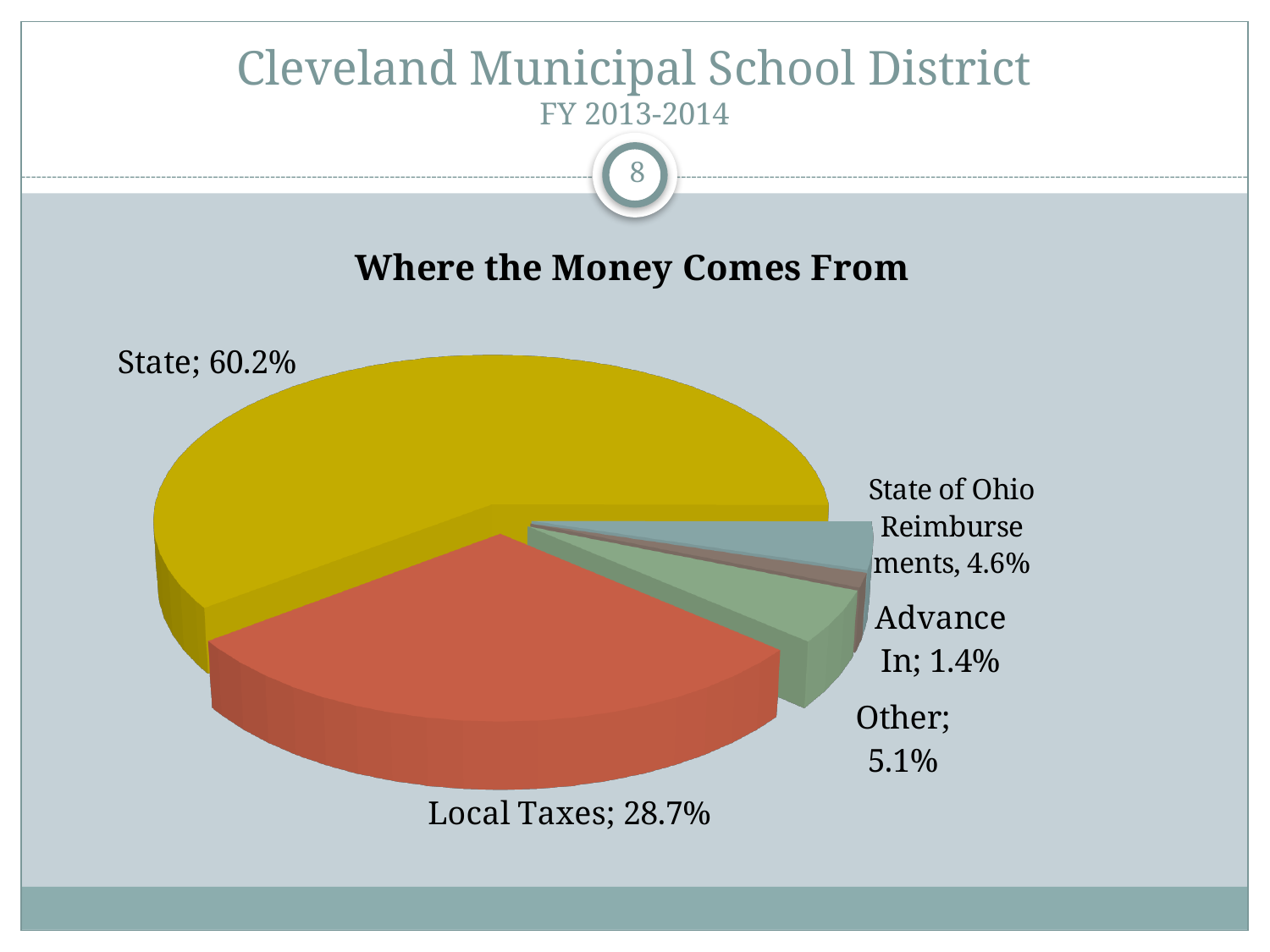
How many percentage points larger is the State share than the Local Taxes share? 31.5 Which source provides the smallest share of the money? Advance In What percentage does the Advance In slice represent? 1.4% What share of the money comes from Other sources? 5.1% Which is larger, the share from Other or the share from State of Ohio Reimbursements? Other What share of the money comes from the State? 60.2% How many slices does the pie chart have? 5 What share is labelled for State of Ohio Reimbursements? 4.6% What percentage of the money comes from Local Taxes? 28.7% Which source provides the largest share of the money? State What type of chart is shown on the slide? Pie chart What is the title of the chart? Where the Money Comes From